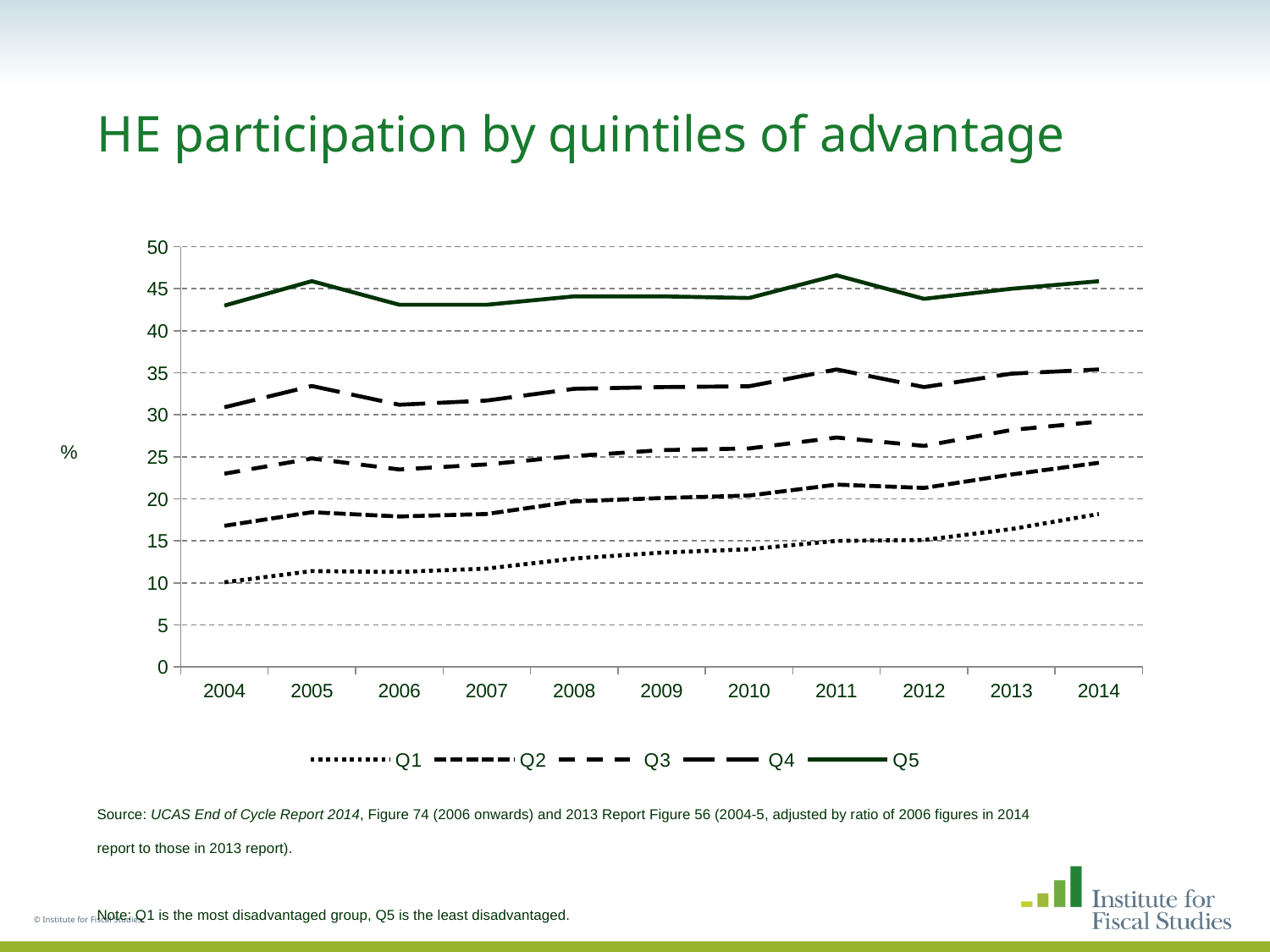
How many series does the legend list? 5 Is the value for Q1 in 2004 greater or less than 15? less How many years are shown on the x axis? 11 What is the title of the chart? HE participation by quintiles of advantage Is the value for Q2 in 2004 greater or less than 20? less In 2014, which is larger, the value for Q3 or the value for Q2? Q3 Does the Q1 line rise or fall from 2004 to 2014? rise Is the value for Q4 in 2014 greater or less than 30? greater Which series has the highest values across all years? Q5 Which series has the lowest values across all years? Q1 What kind of chart is shown on the slide? line chart